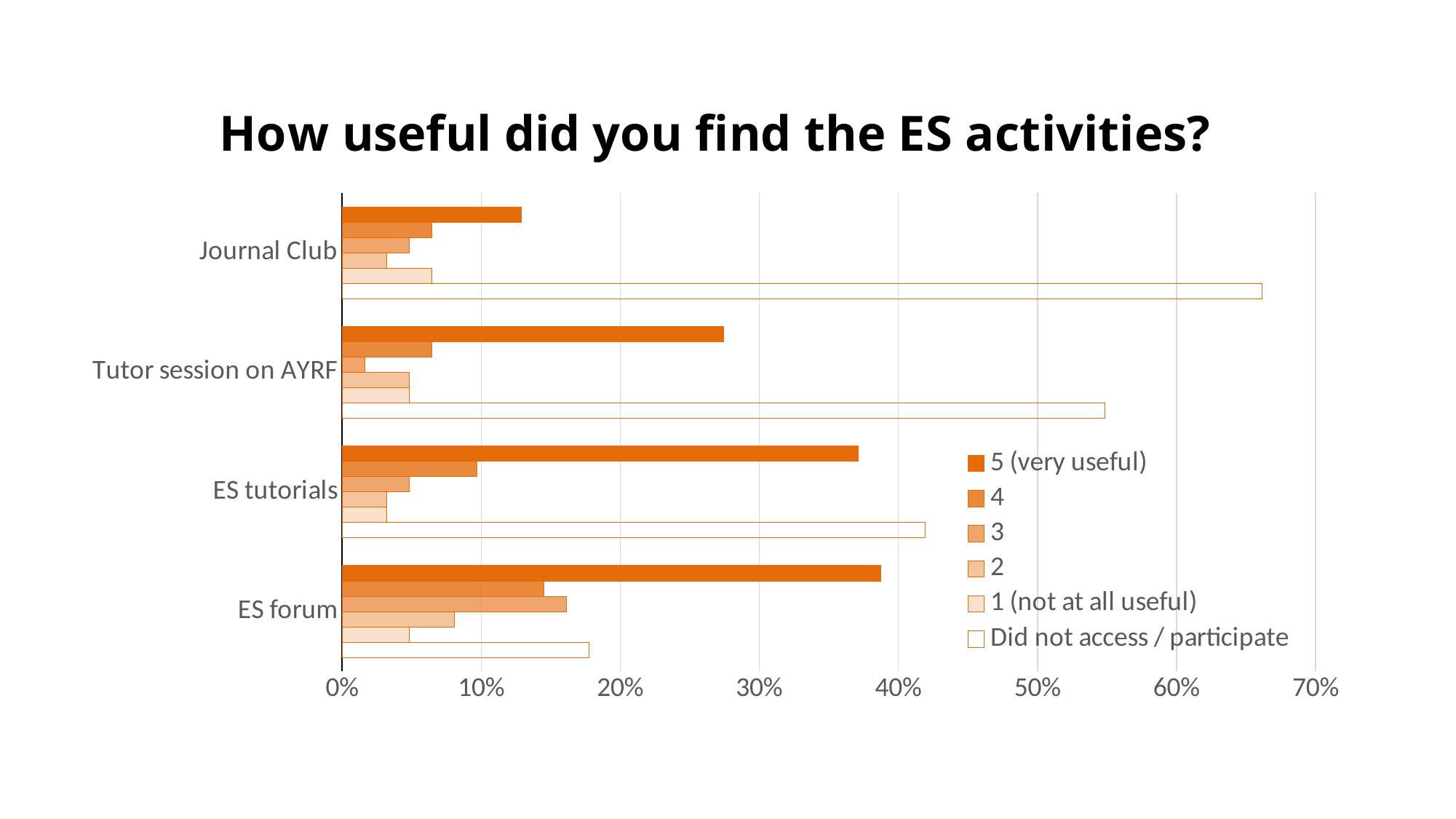
Which activity has the lowest value for 'Did not access / participate'? ES forum For ES tutorials, which is larger: the '5 (very useful)' value or the 'Did not access / participate' value? Did not access / participate What kind of chart is shown on the slide? bar chart How many ES activities are shown on the y axis? 4 What is the title of the chart? How useful did you find the ES activities? Which activity has the highest value for '5 (very useful)'? ES forum Is the 'Did not access / participate' value for ES forum greater or less than 20%? less Is the '5 (very useful)' value for Tutor session on AYRF greater or less than 30%? less Is the 'Did not access / participate' value for Journal Club greater or less than 60%? greater How many series does the legend list? 6 Which activity has the highest value for 'Did not access / participate'? Journal Club